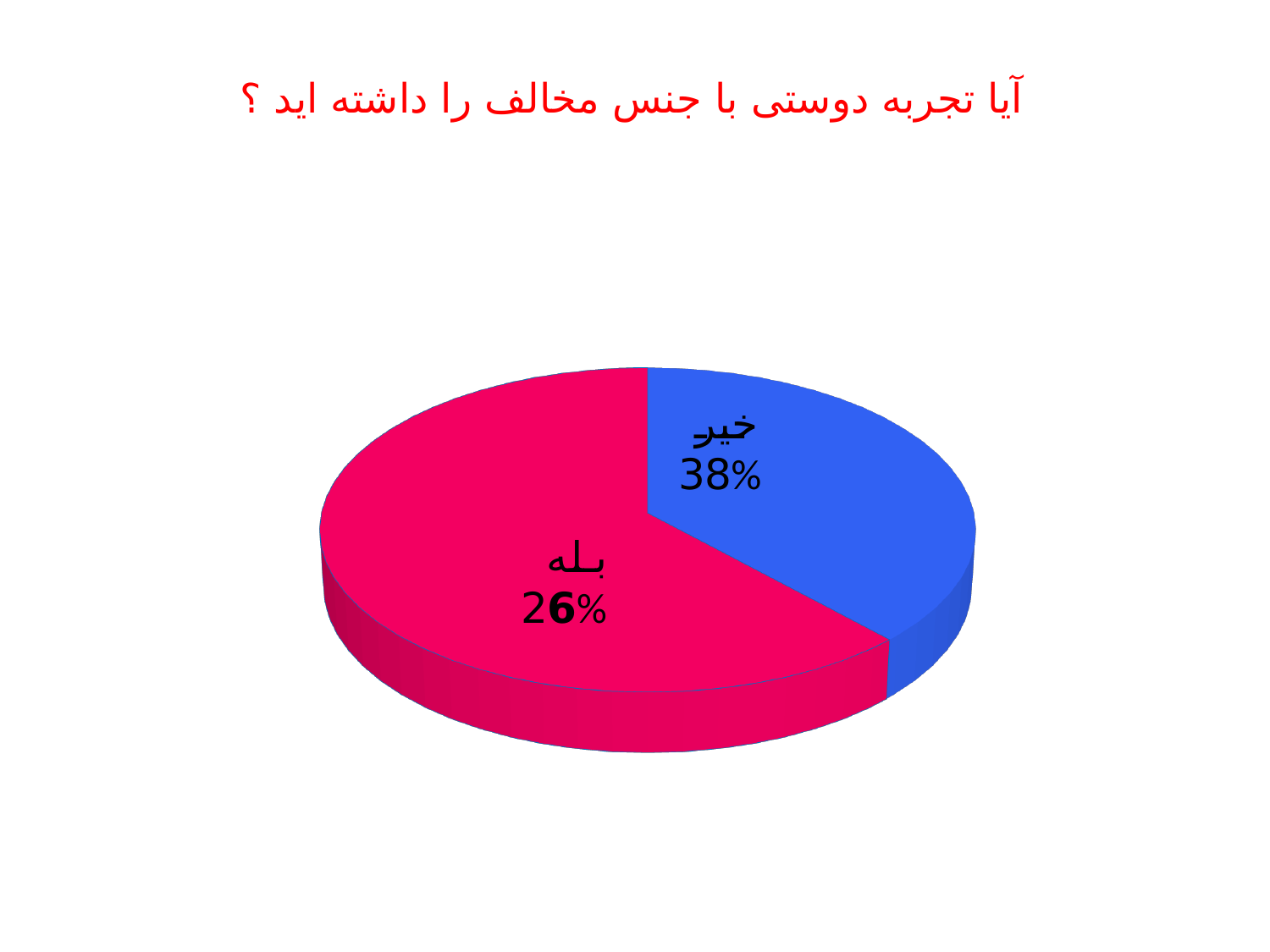
What is the title of the slide above the chart? آیا تجربه دوستی با جنس مخالف را داشته اید ؟ What kind of chart is shown on the slide? Pie chart Which slice of the pie chart is labelled 38%? خیر Which slice of the pie chart is labelled 26%? بله How many slices does the pie chart have? 2 What percentage is shown for the "خیر" slice of the pie chart? 38% What percentage is shown for the "بله" slice of the pie chart? 26% What colour is the "خیر" slice of the pie chart? Blue